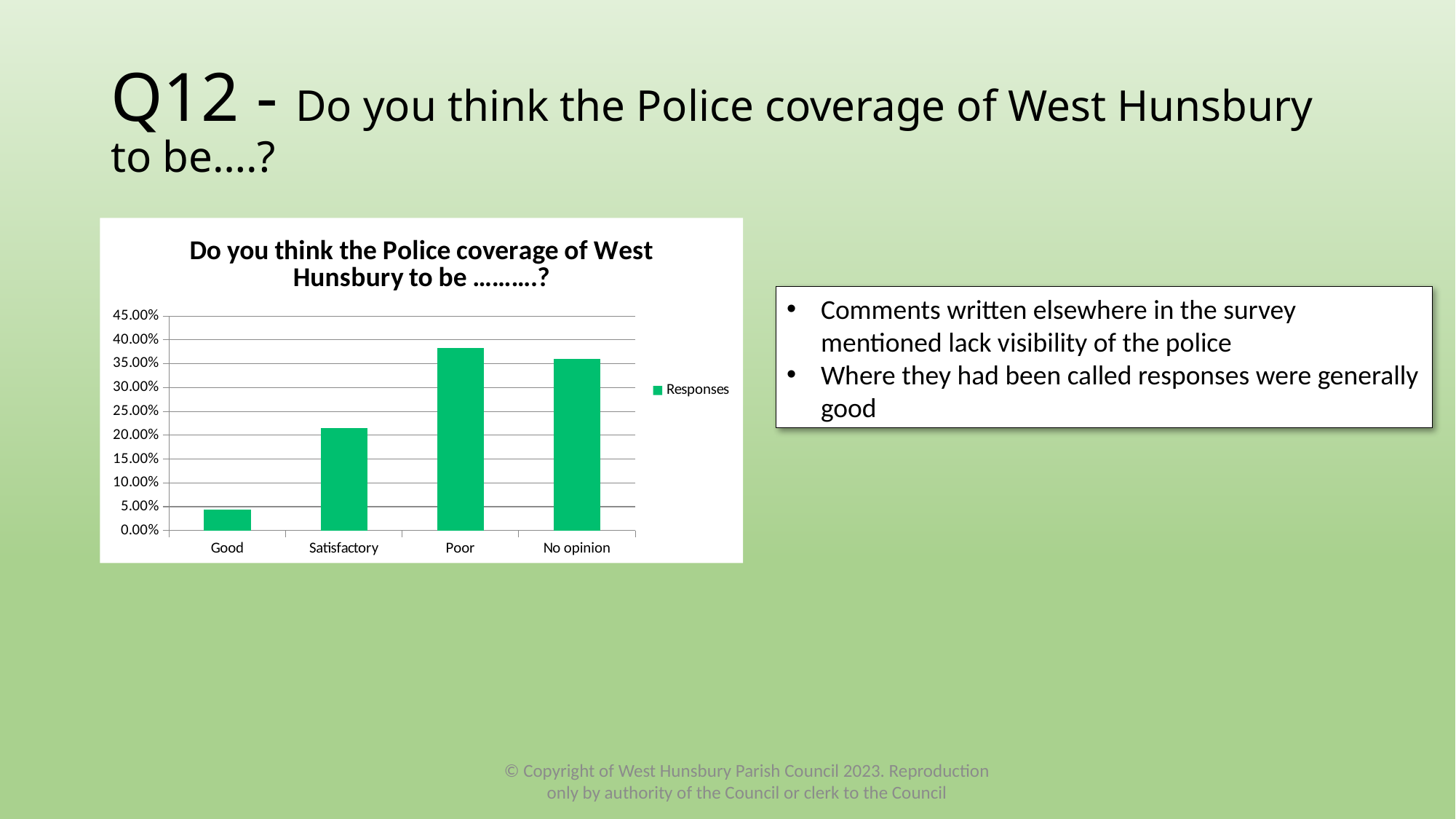
Which category has the highest value in the chart? Poor Is the value for Satisfactory greater or less than 20.00%? greater Is the value for Satisfactory greater or less than 25.00%? less What kind of chart is shown on the slide? bar chart How many categories are shown on the x axis of the chart? 4 Is the value for Poor greater or less than 35.00%? greater How many series does the chart legend list? 1 Which category has the lowest value in the chart? Good What is the name of the series shown in the chart legend? Responses Which is larger, the value for Satisfactory or the value for Good? Satisfactory